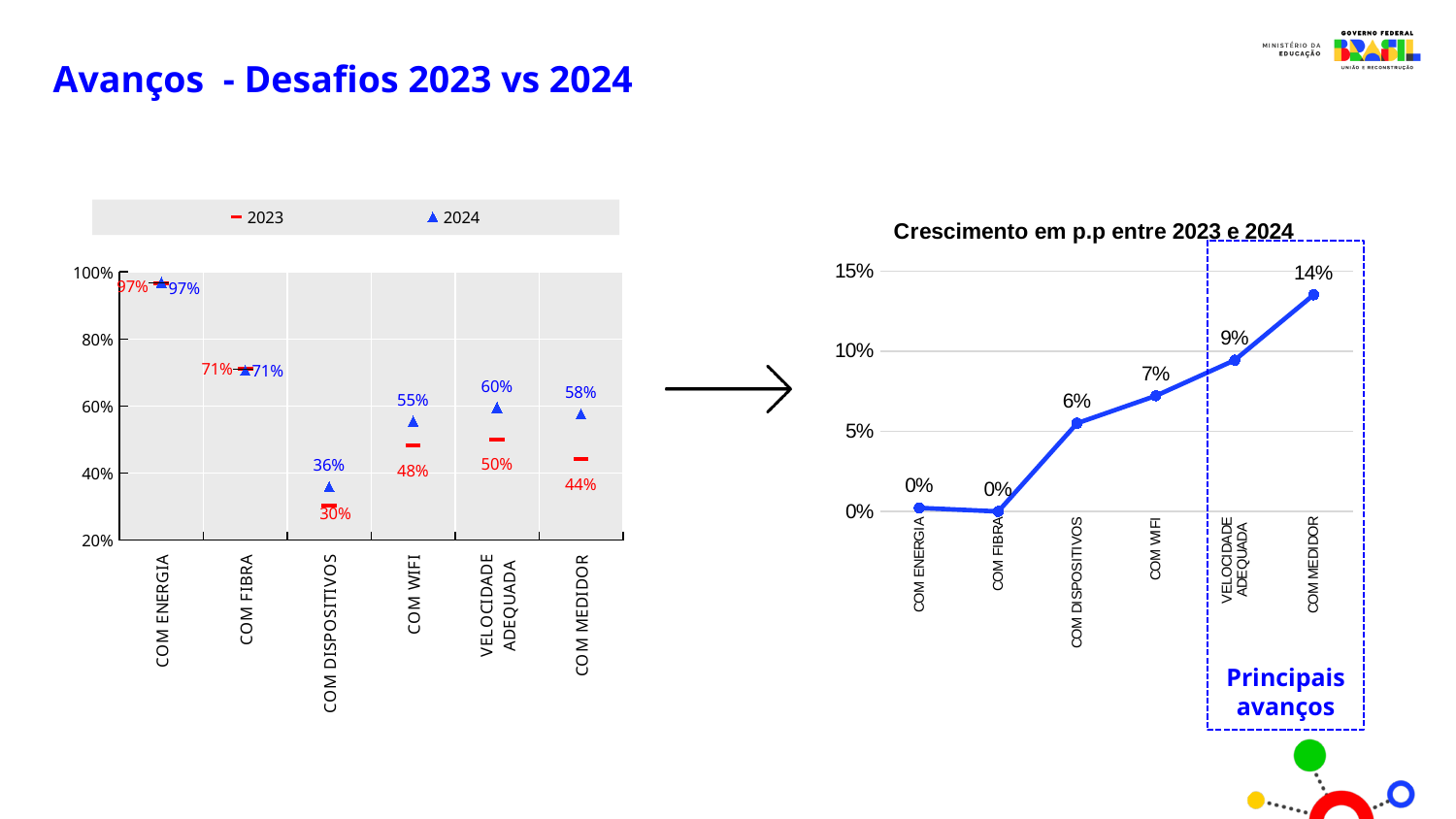
In the left chart, what is the 2024 value for COM WIFI? 55% In the left chart, what is the 2023 value for COM DISPOSITIVOS? 30% In the left chart, what is the difference between the 2024 and 2023 values for VELOCIDADE ADEQUADA? 10% In the chart titled 'Crescimento em p.p entre 2023 e 2024', do the values rise or fall from COM ENERGIA to COM MEDIDOR? rise In the left chart, what is the 2023 value for COM MEDIDOR? 44% In the left chart, which is larger for COM MEDIDOR: the 2023 value or the 2024 value? 2024 In the chart titled 'Crescimento em p.p entre 2023 e 2024', what is the value for COM DISPOSITIVOS? 6% In the left chart, which category has the lowest 2023 value? COM DISPOSITIVOS In the chart titled 'Crescimento em p.p entre 2023 e 2024', what is the value for COM MEDIDOR? 14% What kind of chart is the chart titled 'Crescimento em p.p entre 2023 e 2024'? line chart How many series does the legend of the left chart list? 2 In the left chart, which category has the highest 2024 value? COM ENERGIA